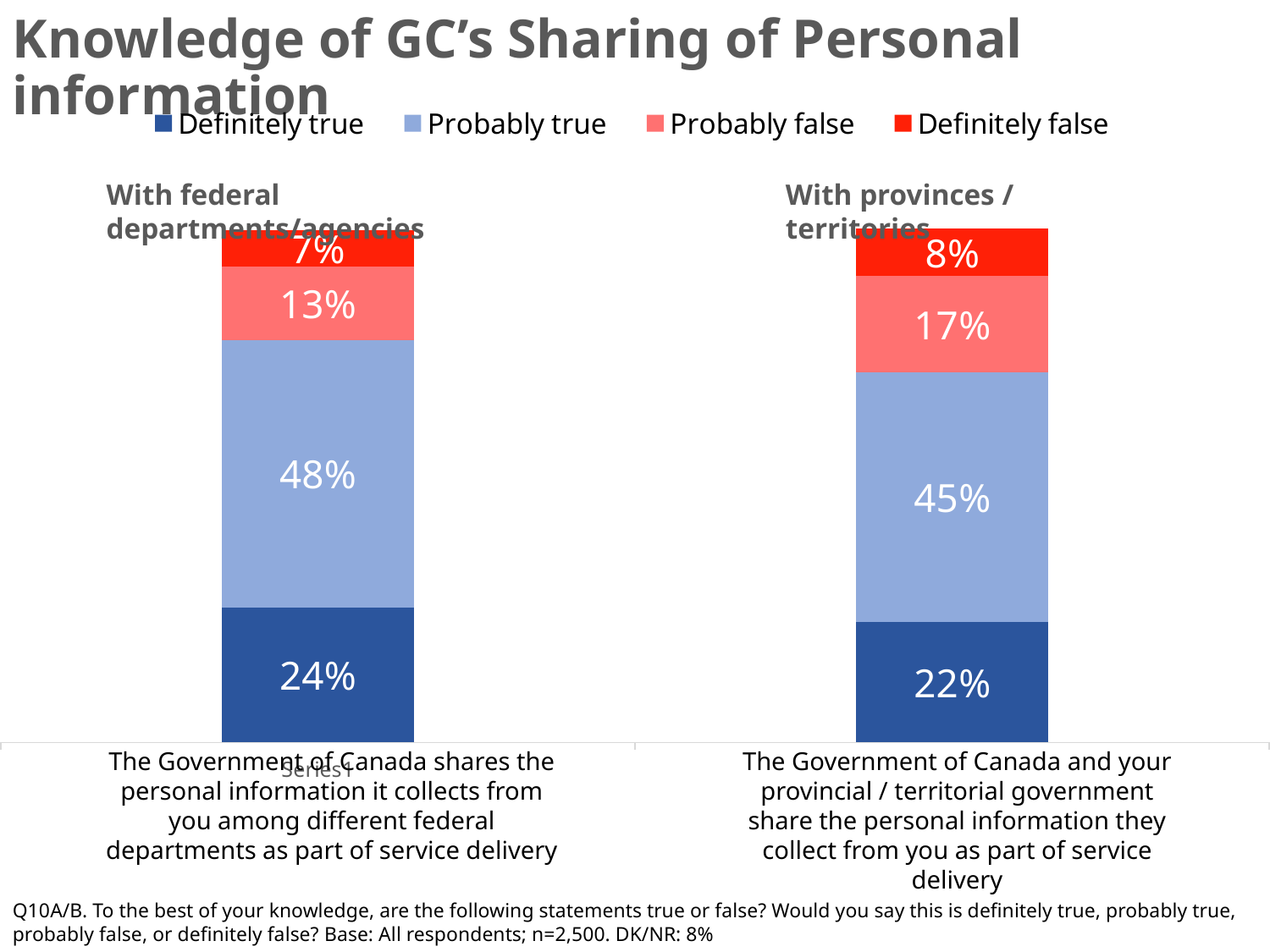
What is the difference between the 'Probably true' values for federal departments/agencies and provinces / territories? 3 percentage points Which bar has the larger 'Probably false' value, 'With federal departments/agencies' or 'With provinces / territories'? With provinces / territories What is the total of the labelled segments in the 'With federal departments/agencies' bar? 92% Which response category has the largest share in the 'With federal departments/agencies' bar? Probably true Which response category has the smallest share in the 'With provinces / territories' bar? Definitely false What kind of chart is shown on the slide? Stacked bar chart What percentage of respondents said it is definitely true that the Government of Canada shares personal information with federal departments/agencies? 24% What is the 'Probably false' value for the 'With provinces / territories' bar? 17% What is the 'Probably true' value for the 'With provinces / territories' bar? 45% What colour represents 'Definitely true' in the chart? Dark blue How many series does the legend list? 4 What is the 'Definitely false' value for the 'With federal departments/agencies' bar? 7%